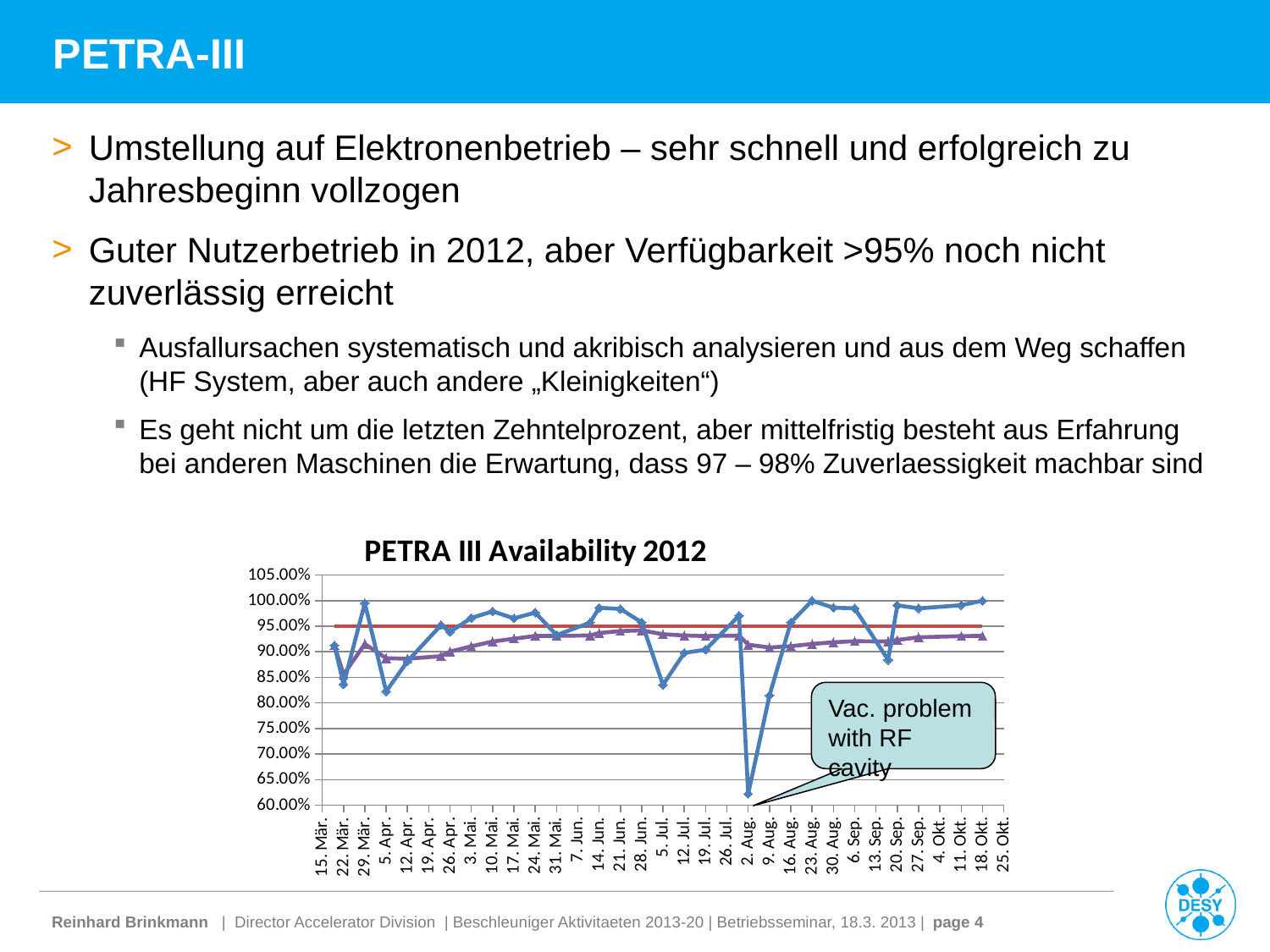
What kind of chart is shown on the slide? line chart Is the blue line's value for 29. Mär. greater or less than 95.00%? greater What does the callout box on the chart say caused the dip in early August? Vac. problem with RF cavity Is the blue line's value for 2. Aug. greater or less than 65.00%? less At what value does the flat red horizontal line sit on the y axis? 95.00% Is the blue line's value for 5. Apr. greater or less than 85.00%? less What is the lowest value shown on the y axis? 60.00% Which has the higher blue-line value, 29. Mär. or 5. Apr.? 29. Mär. On which date does the blue line reach its lowest value? 2. Aug. What is the title of the chart? PETRA III Availability 2012